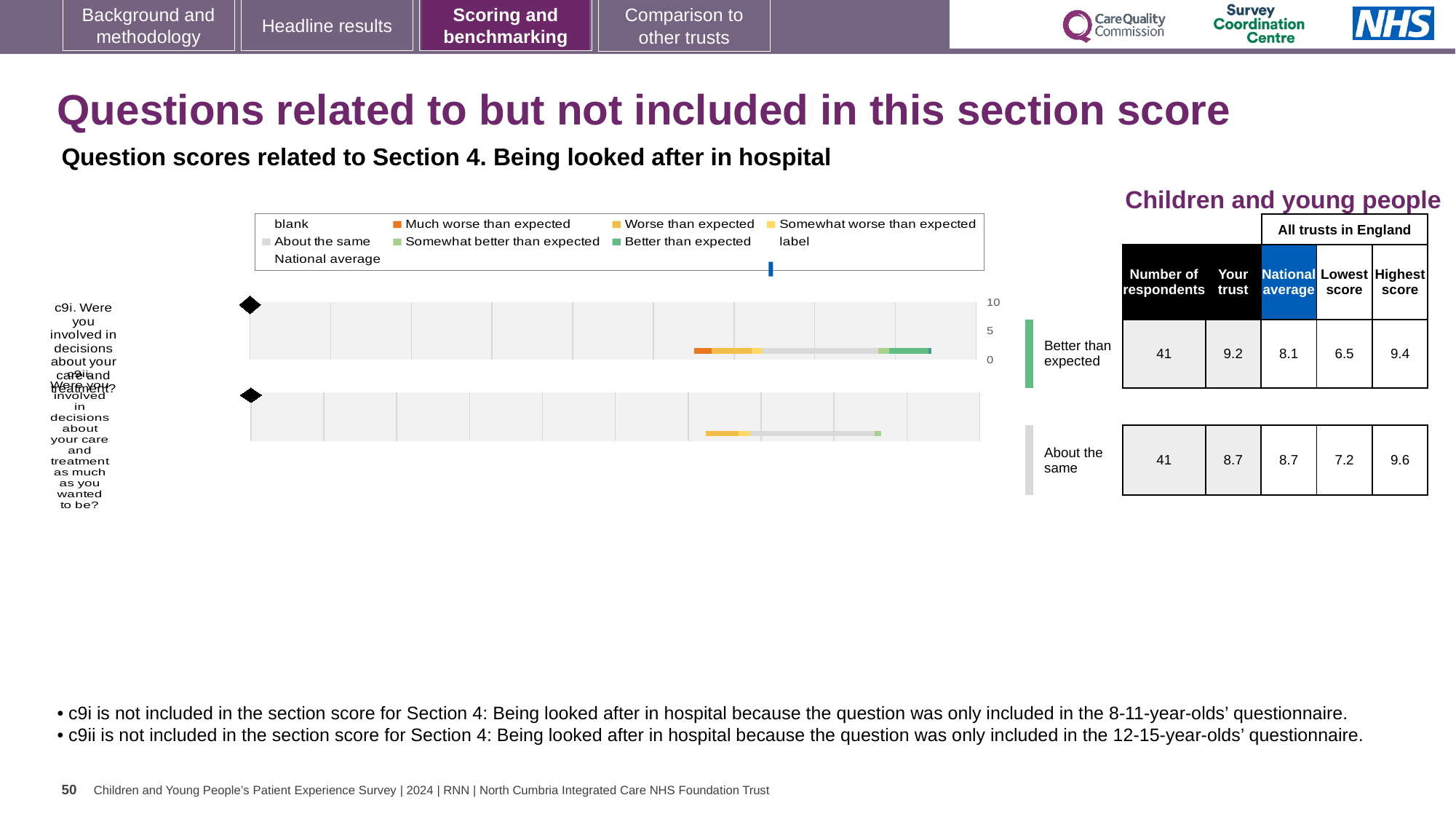
By how much does the 'Your trust' score for c9i exceed the national average for c9i, according to the table beside the chart? 1.1 According to the table beside the chart, what is the national average for c9i? 8.1 According to the table beside the chart, what is the 'Your trust' score for c9ii? 8.7 According to the table beside the chart, what is the highest score across all trusts in England for c9ii? 9.6 What kind of chart is shown on the slide? bar chart According to the table beside the chart, what is the 'Your trust' score for c9i? 9.2 What is the highest value shown on the chart's numeric axis? 10 According to the table beside the chart, what is the lowest score across all trusts in England for c9i? 6.5 Which is larger for c9i according to the table beside the chart: the 'Your trust' score or the national average? Your trust According to the table beside the chart, what is the number of respondents for c9ii? 41 Which legend entry is shown with a dark green colour? Better than expected How many questions (categories) are plotted in the chart? 2